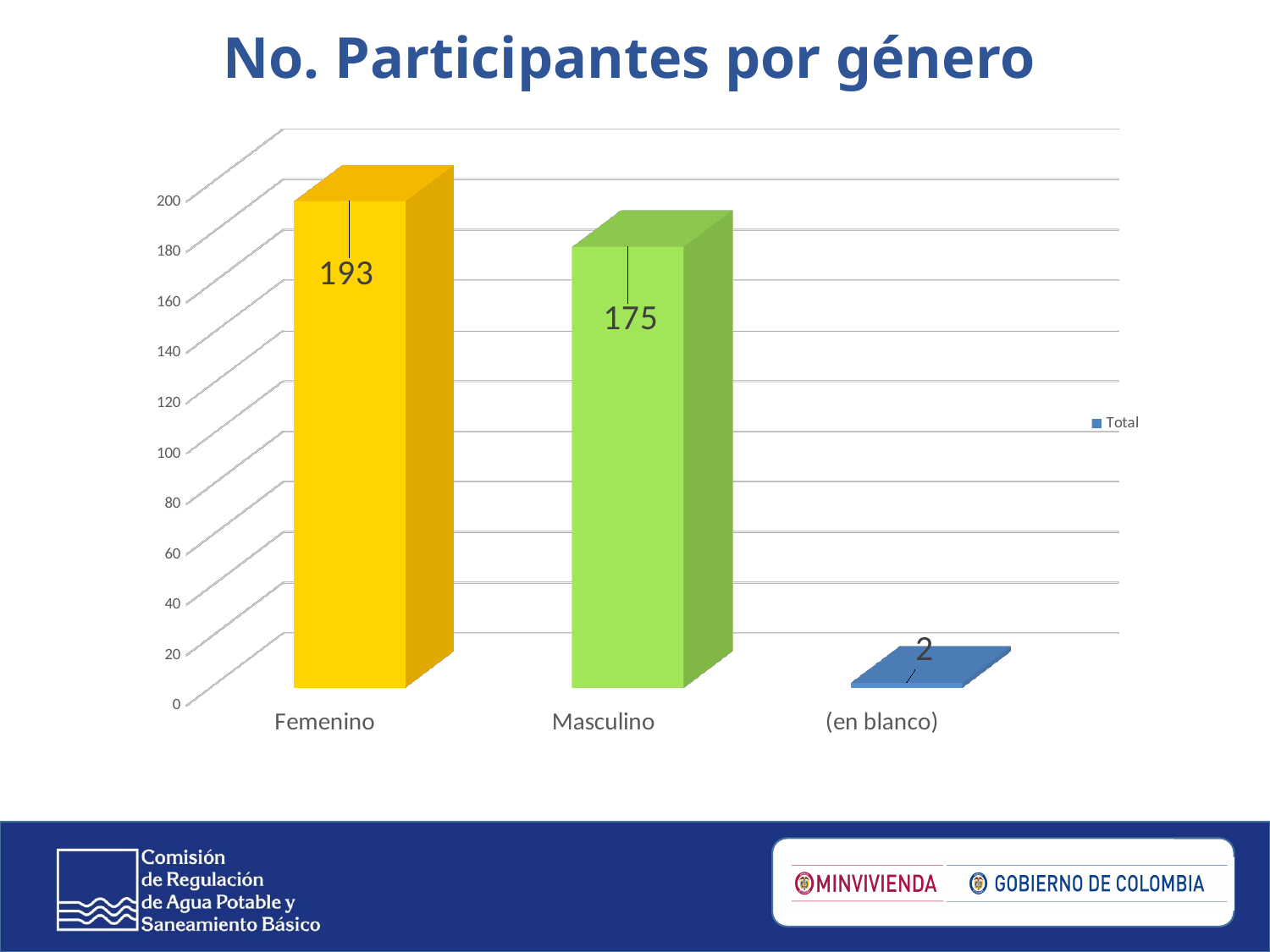
Which category has the highest number of participants? Femenino How many categories are shown on the x axis? 3 Is the value for Masculino greater or less than 160? greater What is the value for Femenino? 193 What is the title of the chart? No. Participantes por género Which is larger, the value for Masculino or the value for (en blanco)? Masculino What kind of chart is shown on the slide? bar chart What is the value for Masculino? 175 Which category has the lowest number of participants? (en blanco) How many series does the legend list? 1 What is the difference between the values for Femenino and Masculino? 18 What is the value for (en blanco)? 2